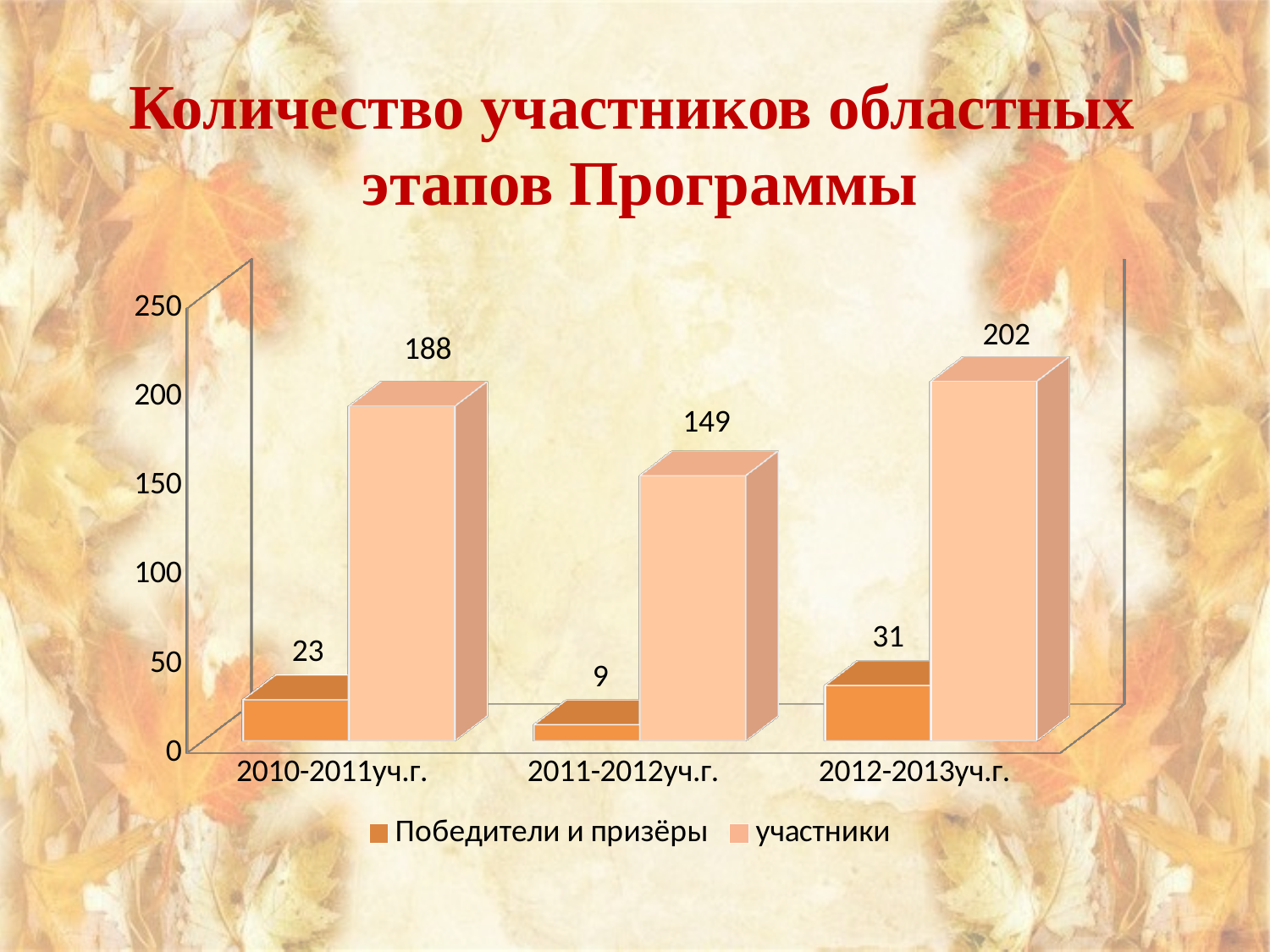
What is the value for участники in 2011-2012уч.г.? 149 How many series does the legend list? 2 Which year has the lowest value for Победители и призёры? 2011-2012уч.г. Which year has the highest value for участники? 2012-2013уч.г. How many years are shown on the x axis? 3 What is the value for Победители и призёры in 2010-2011уч.г.? 23 What is the value for участники in 2012-2013уч.г.? 202 Which is larger: участники in 2010-2011уч.г. or участники in 2011-2012уч.г.? 2010-2011уч.г. What is the title of the slide? Количество участников областных этапов Программы What is the difference between участники in 2012-2013уч.г. and 2011-2012уч.г.? 53 What is the difference between Победители и призёры in 2012-2013уч.г. and 2010-2011уч.г.? 8 What kind of chart is shown on the slide? bar chart